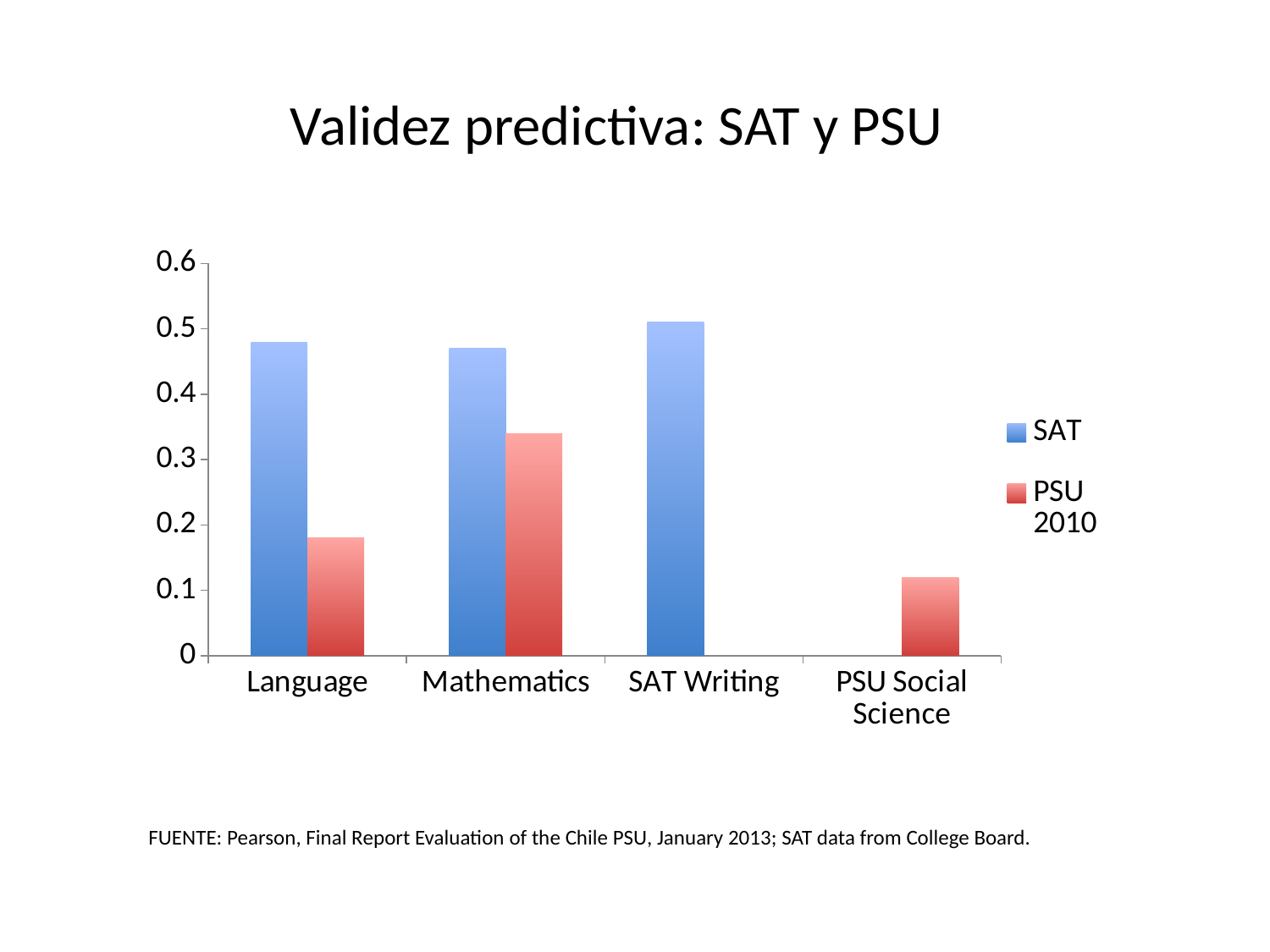
What kind of chart is shown on the slide? bar chart How many series does the legend list? 2 What is the title of the chart on the slide? Validez predictiva: SAT y PSU Which category has the highest SAT value? SAT Writing For Mathematics, which is larger, the SAT value or the PSU 2010 value? SAT Which category has the highest PSU 2010 value? Mathematics How many categories are shown on the x axis? 4 Is the PSU 2010 value for Mathematics greater or less than 0.3? greater Which category has the lowest PSU 2010 value? PSU Social Science Is the PSU 2010 value for PSU Social Science greater or less than 0.2? less Is the SAT value for Language greater or less than 0.4? greater